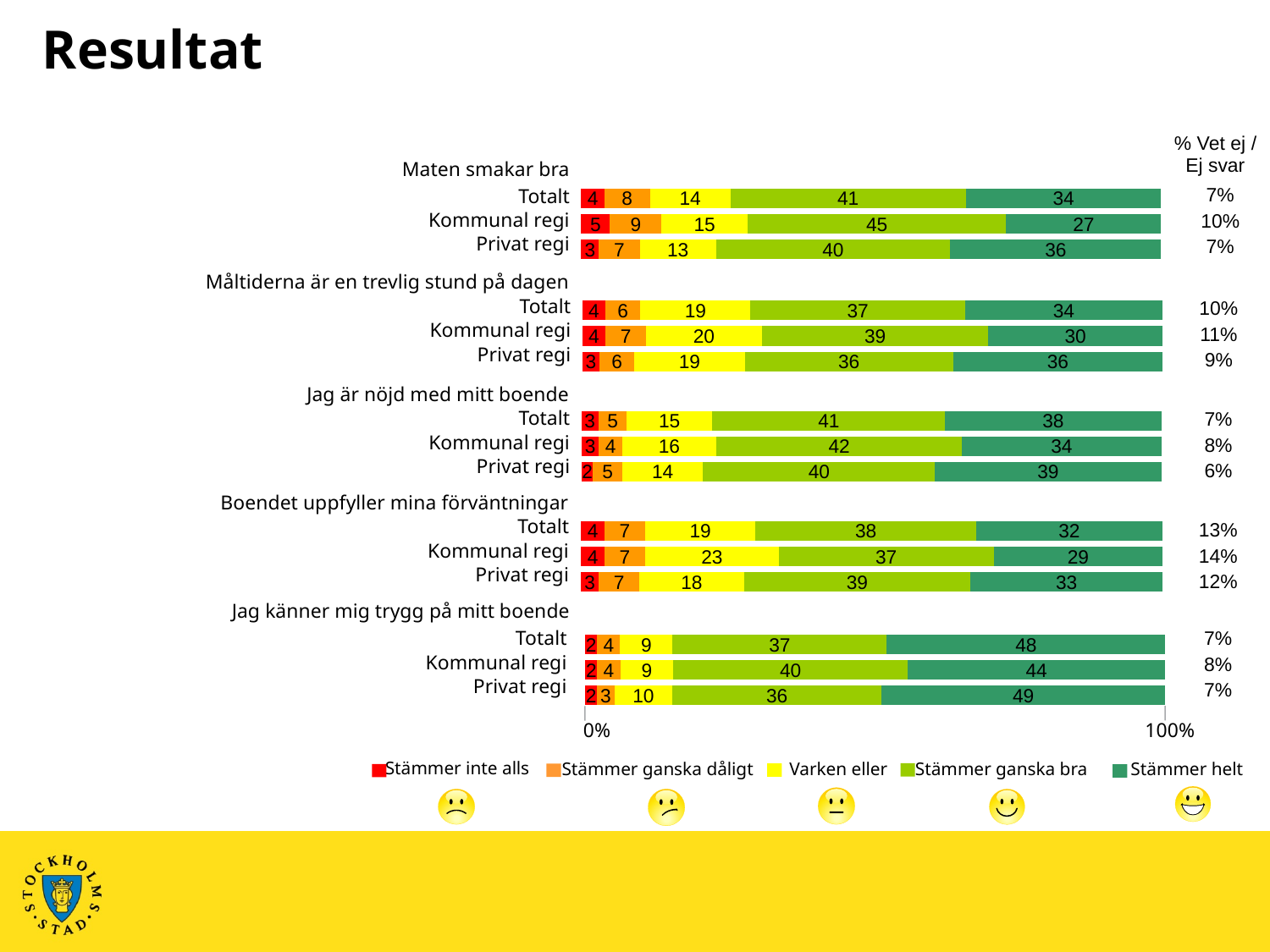
What is the value of "Stämmer ganska dåligt" for Kommunal regi under "Måltiderna är en trevlig stund på dagen"? 7 How many series does the legend list? 5 How many bars are plotted in the chart? 15 Under "Måltiderna är en trevlig stund på dagen", which row has the lowest "Stämmer helt" value? Kommunal regi Which Totalt bar has the larger "Stämmer helt" value: "Jag är nöjd med mitt boende" or "Maten smakar bra"? Jag är nöjd med mitt boende What kind of chart is shown on the slide? Stacked bar chart Which bar has the highest "Stämmer helt" value? Privat regi under "Jag känner mig trygg på mitt boende" What is the "% Vet ej / Ej svar" value for Kommunal regi under "Boendet uppfyller mina förväntningar"? 14% What is the value of "Stämmer helt" for Privat regi under "Jag känner mig trygg på mitt boende"? 49 What is the value of "Varken eller" for Kommunal regi under "Boendet uppfyller mina förväntningar"? 23 What is the total of the Totalt bar under "Jag känner mig trygg på mitt boende"? 100 Under "Maten smakar bra", what is the difference in "Stämmer ganska bra" between Kommunal regi and Privat regi? 5